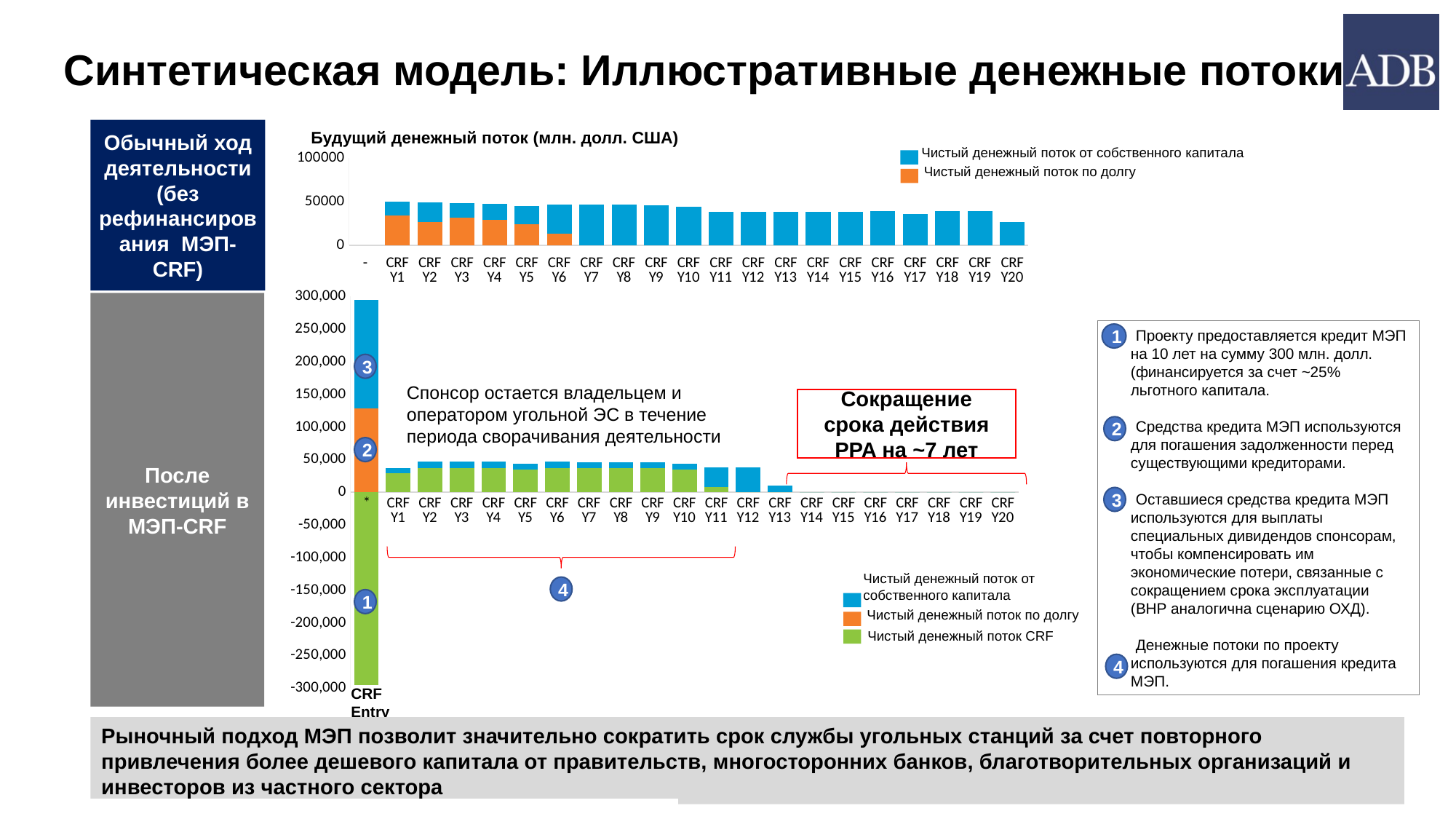
In the bottom chart, is the top of the blue segment of the CRF Entry bar greater or less than 250,000? greater In the bottom chart, which is larger, the bar for CRF Y12 or for CRF Y13? CRF Y12 How many series does the legend of the top chart list? 2 In the top chart, do the total bar values generally rise or fall from CRF Y1 to CRF Y20? Fall In the top chart, which is larger, the total bar for CRF Y1 or for CRF Y20? CRF Y1 In the bottom chart, which category has the tallest bar? CRF Entry In the top chart, is the total value for CRF Y20 greater or less than 50000? less In the top chart, what is the last year in which the orange series 'Чистый денежный поток по долгу' appears? CRF Y6 How many series does the legend of the bottom chart list? 3 In the bottom chart, is the total value for CRF Y13 greater or less than 50,000? less In the bottom chart, what colour represents 'Чистый денежный поток CRF'? Green What kind of chart is the top chart titled 'Будущий денежный поток (млн. долл. США)'? Bar chart